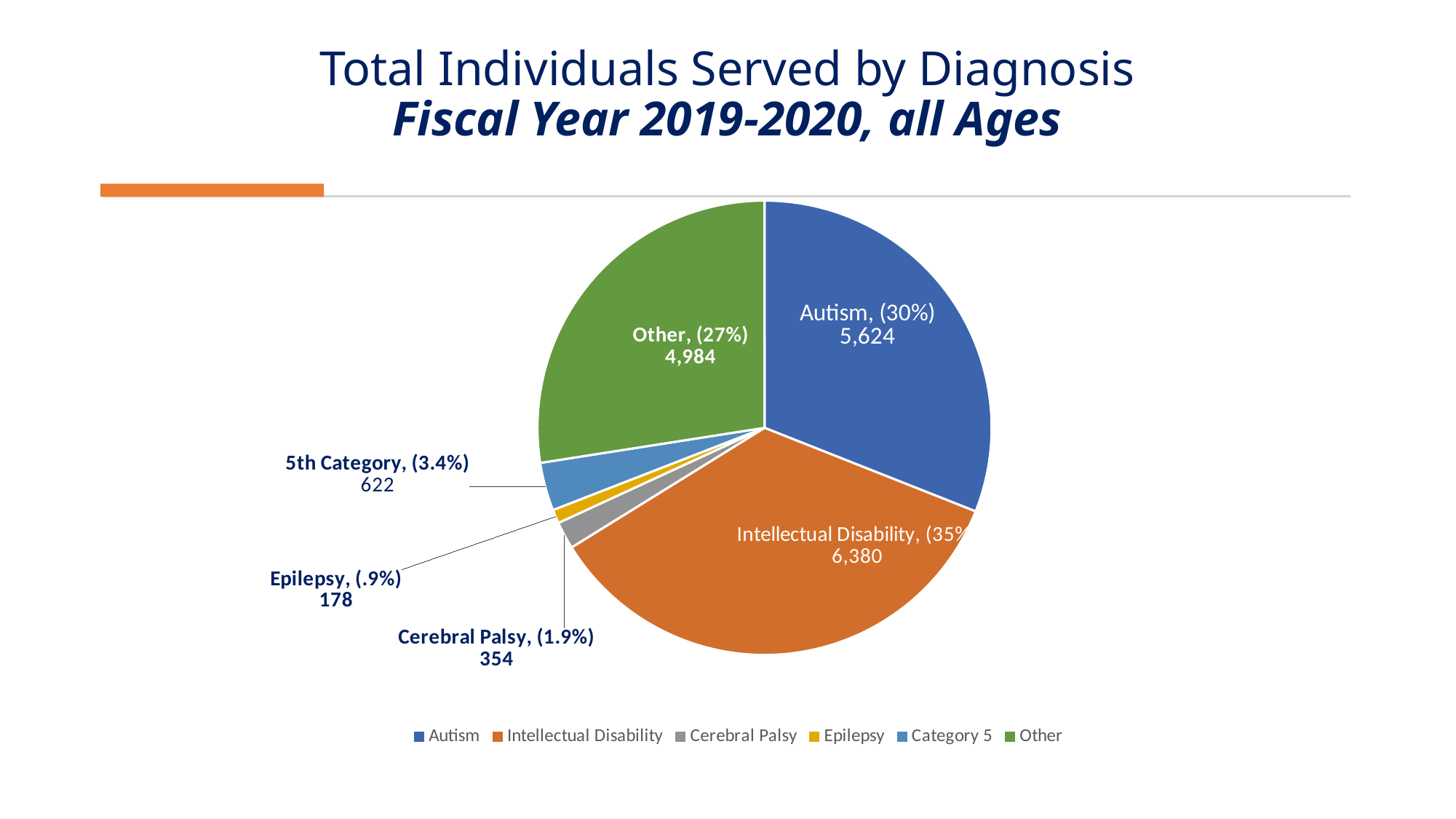
How many individuals were served with a diagnosis of Intellectual Disability? 6,380 Which is larger, the number served for Cerebral Palsy or for Epilepsy? Cerebral Palsy What is the difference between the number of individuals served for Intellectual Disability and for Autism? 756 What type of chart is shown on the slide? pie chart How many entries does the legend list? 6 Which diagnosis category has the smallest slice of the pie? Epilepsy What share of the pie does the Other category represent? 27% How many individuals were served with a diagnosis of Cerebral Palsy? 354 What share of the pie does the 5th Category represent? 3.4% How many individuals were served with a diagnosis of Epilepsy? 178 How many individuals were served with a diagnosis of Autism? 5,624 Which diagnosis category has the largest slice of the pie? Intellectual Disability